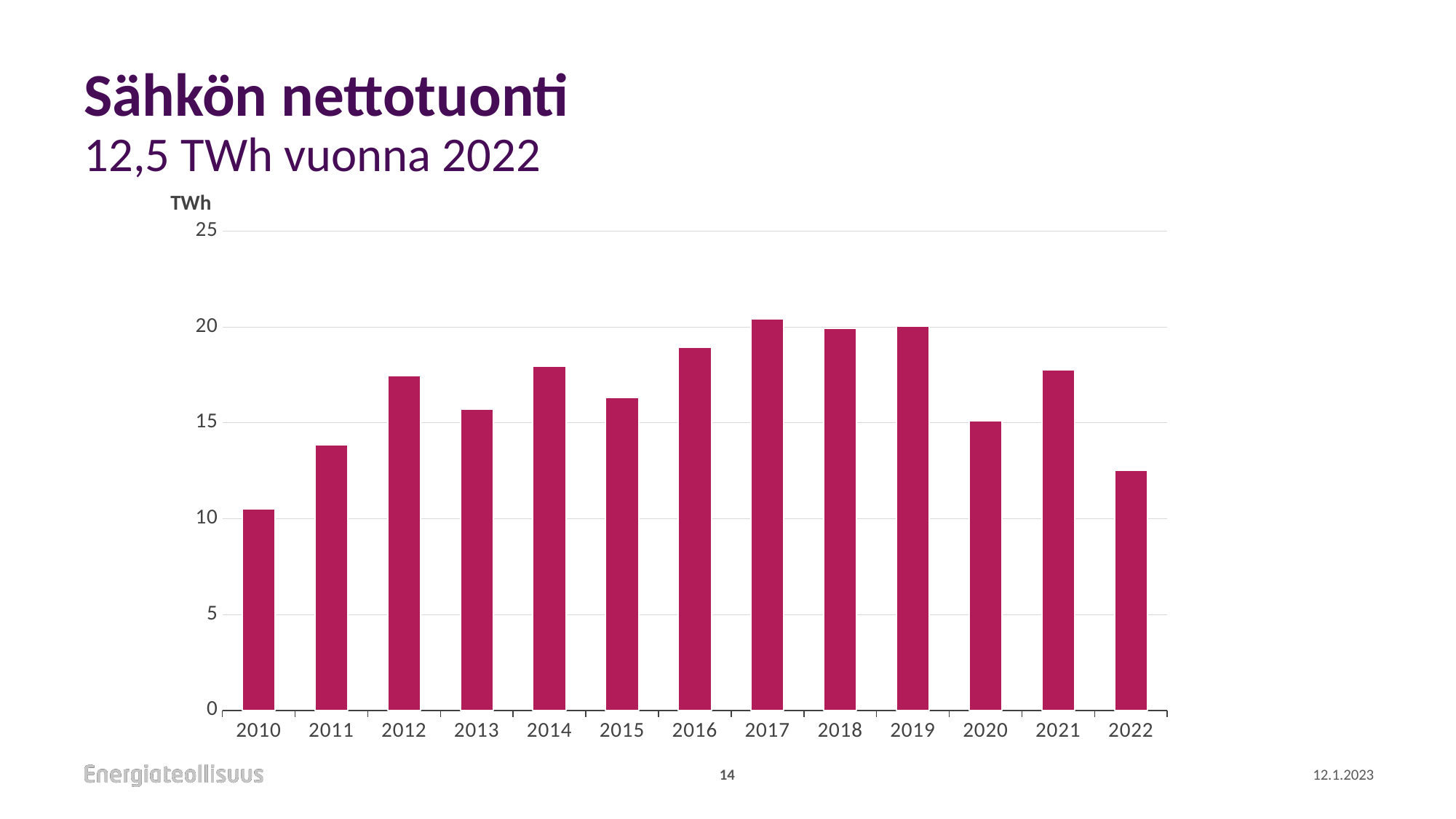
Is the value for 2011 greater or less than 15? less Is the value for 2016 greater or less than 20? less How many years (bars) are shown in the chart? 13 What kind of chart is shown on the slide? bar chart Is the value for 2012 greater or less than 15? greater Which is larger, the value for 2021 or the value for 2022? 2021 What unit is shown on the vertical axis of the chart? TWh Which year has the highest bar in the chart? 2017 Do the values rise or fall from 2019 to 2022? fall What is the net import of electricity in 2022 according to the slide? 12,5 TWh Which year has the lowest bar in the chart? 2010